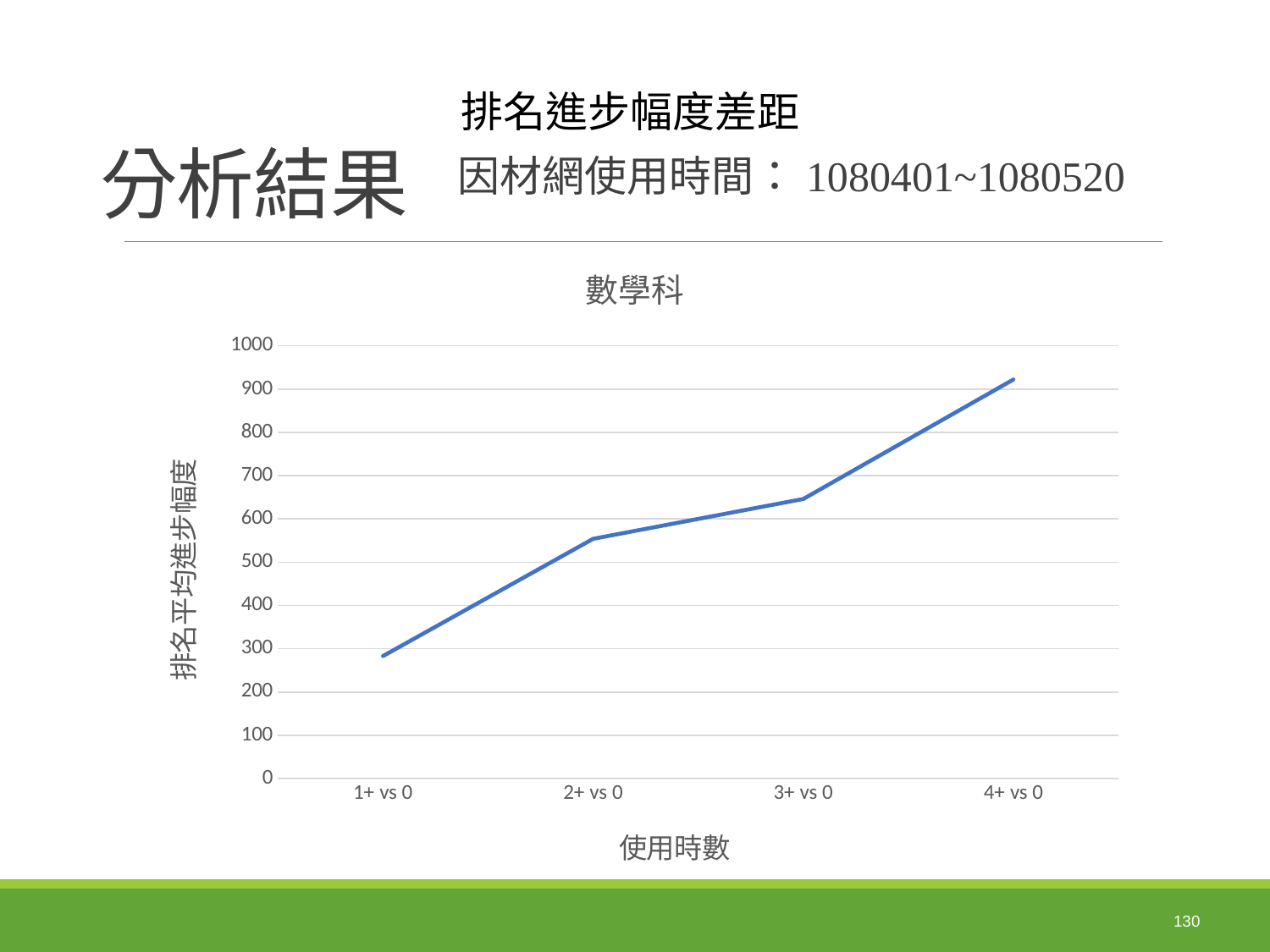
What is the title of the x axis? 使用時數 How many categories are plotted along the x axis? 4 Is the value for 4+ vs 0 greater or less than 800? greater Which category has the highest value? 4+ vs 0 Which is larger, the value for 2+ vs 0 or the value for 3+ vs 0? 3+ vs 0 What is the title of the chart? 數學科 Is the value for 3+ vs 0 greater or less than 600? greater Is the value for 2+ vs 0 greater or less than 500? greater What type of chart is shown on the slide? line chart Do the values rise or fall from 1+ vs 0 to 4+ vs 0? rise Which category has the lowest value? 1+ vs 0